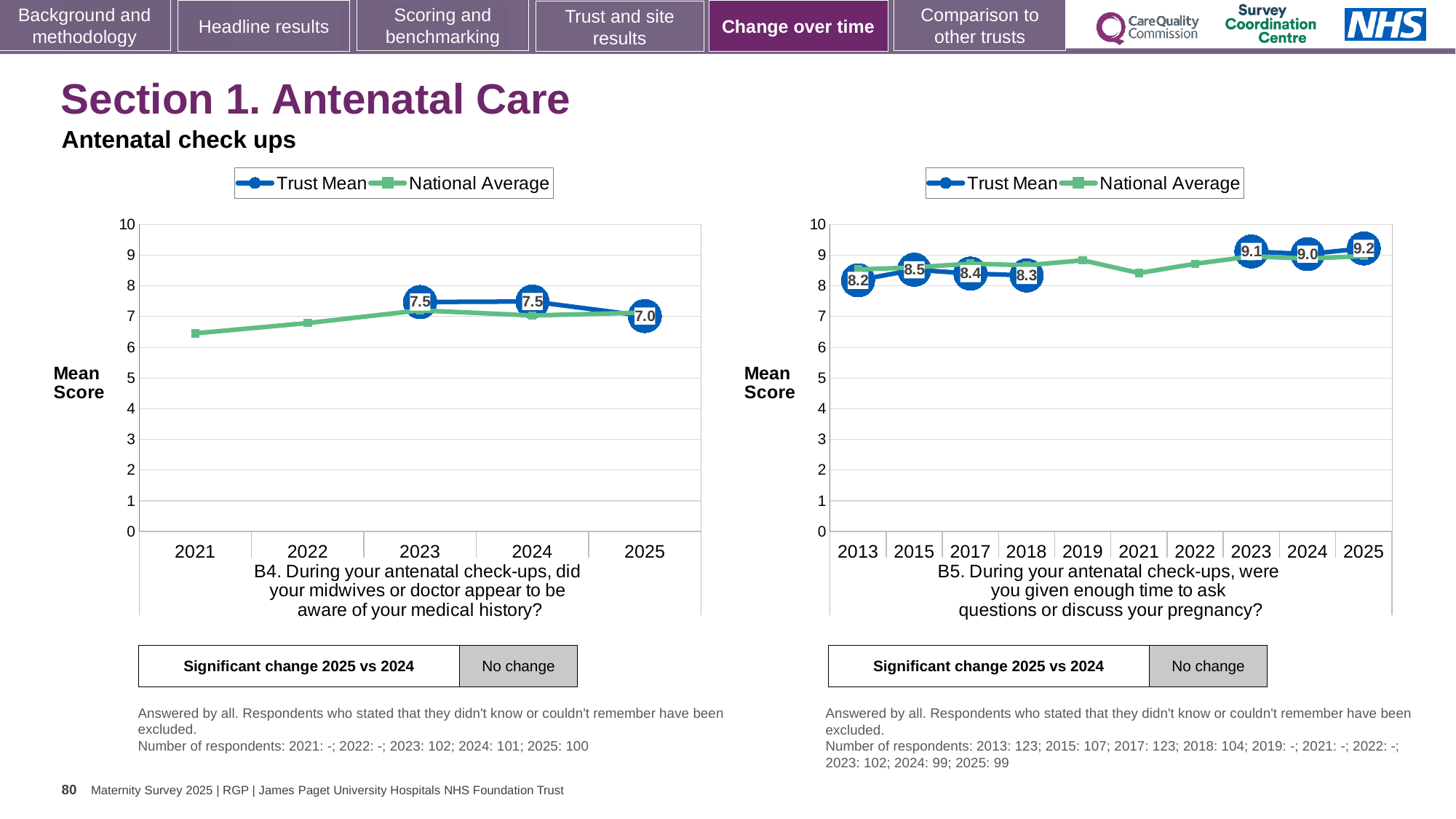
How many years are shown on the x axis of the B5 chart (right)? 10 In the B5 chart (right), what is the Trust Mean for 2025? 9.2 In the B5 chart (right), is the Trust Mean for 2018 larger or smaller than the Trust Mean for 2023? smaller In the B5 chart (right), what is the Trust Mean for 2013? 8.2 In the B5 chart (right), which year has the lowest Trust Mean? 2013 In the B4 chart (left), what is the Trust Mean for 2023? 7.5 In the B4 chart (left), what is the Trust Mean for 2025? 7.0 In the B4 chart (left), is the National Average for 2021 greater or less than 7? less What type of chart is the B4 chart (left)? line chart In the B5 chart (right), which year has the highest Trust Mean? 2025 In the B4 chart (left), what is the difference between the Trust Mean for 2024 and the Trust Mean for 2025? 0.5 In the B5 chart (right), what is the difference between the Trust Mean for 2025 and the Trust Mean for 2013? 1.0